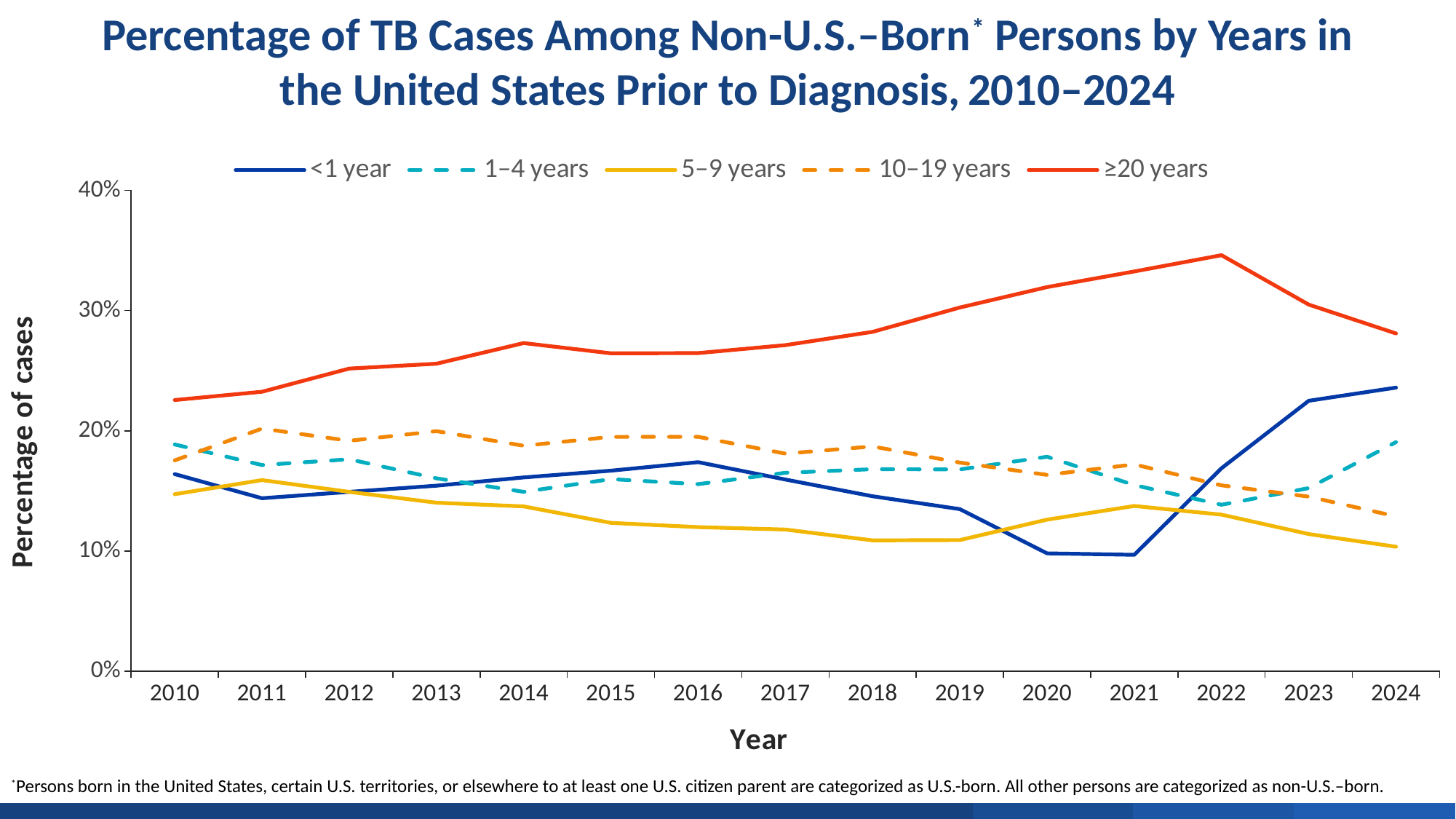
What is the label of the y axis? Percentage of cases Is the value for 5–9 years in 2024 greater or less than 20%? less How many years are shown along the x axis? 15 Is the value for <1 year in 2024 greater or less than 20%? greater How many series does the legend list? 5 What kind of chart is shown on the slide? Line chart In 2020, which is larger: the value for 10–19 years or the value for <1 year? 10–19 years Which series has the highest value in 2024? ≥20 years Does the ≥20 years series rise or fall from 2010 to 2022? Rise In which year does the ≥20 years series reach its highest value? 2022 Is the value for ≥20 years in 2022 greater or less than 30%? greater Which series has the lowest value in 2024? 5–9 years